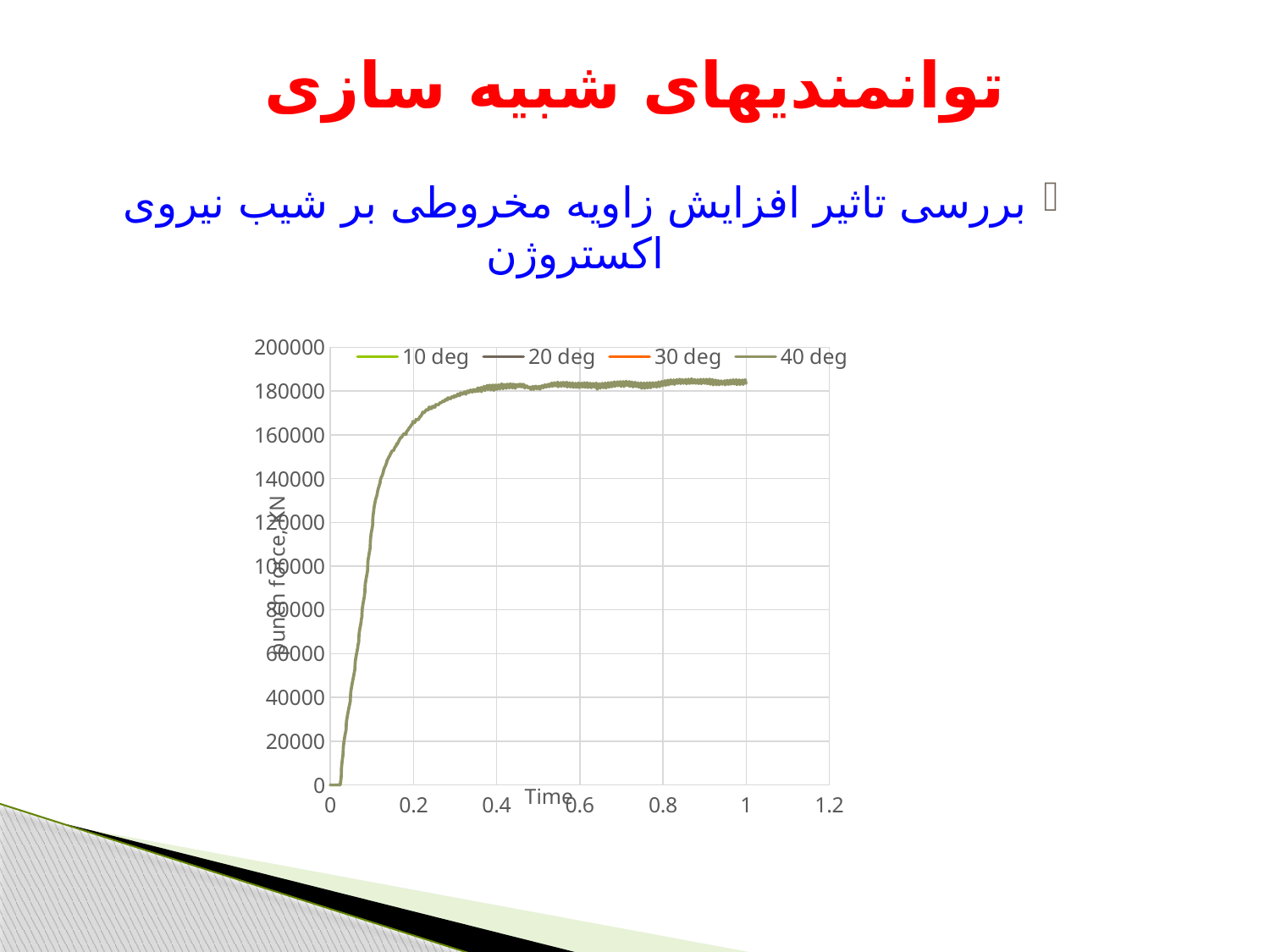
Is the punch force at time 0.6 greater or less than 160000? greater Is the punch force at time 1 greater or less than 180000? greater Is the punch force at time 0.2 greater or less than 180000? less What is the highest value shown on the y axis? 200000 What is the label of the x axis? Time Does the punch force rise or fall as time increases from 0 to 0.2? rise What kind of chart is shown on the slide? line chart What are the series names listed in the legend? 10 deg, 20 deg, 30 deg, 40 deg How many series does the legend list? 4